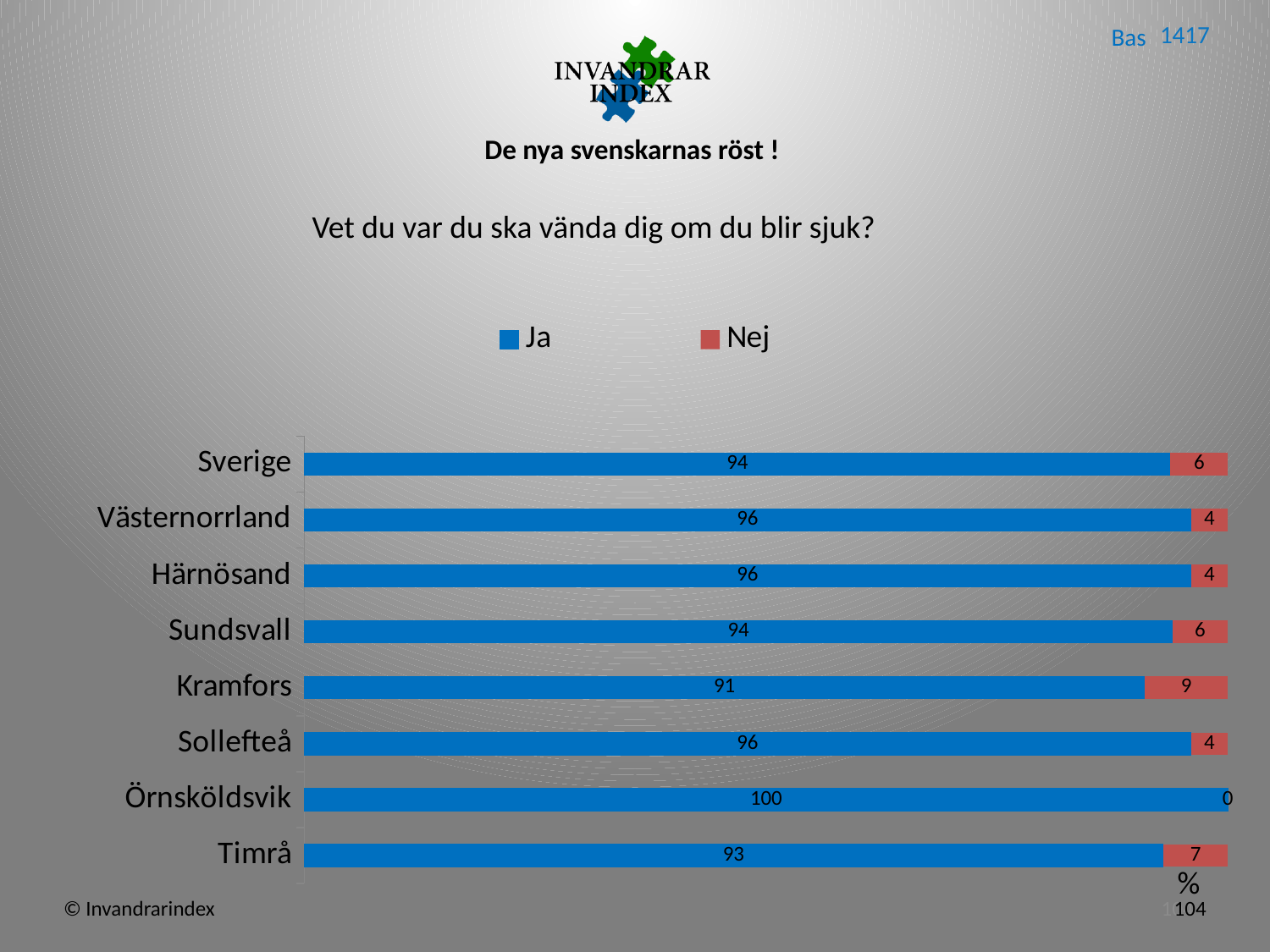
How many categories are shown on the chart? 8 Which category has the highest Ja value? Örnsköldsvik Which category has the lowest Ja value? Kramfors What is the Ja value for Örnsköldsvik? 100 Which is larger, the Nej value for Timrå or the Nej value for Sundsvall? Timrå What kind of chart is shown on the slide? Stacked bar chart What is the Nej value for Timrå? 7 What is the Ja value for Kramfors? 91 Which category has the highest Nej value? Kramfors What is the difference between the Ja values for Örnsköldsvik and Kramfors? 9 What is the Nej value for Sverige? 6 How many series does the legend list? 2